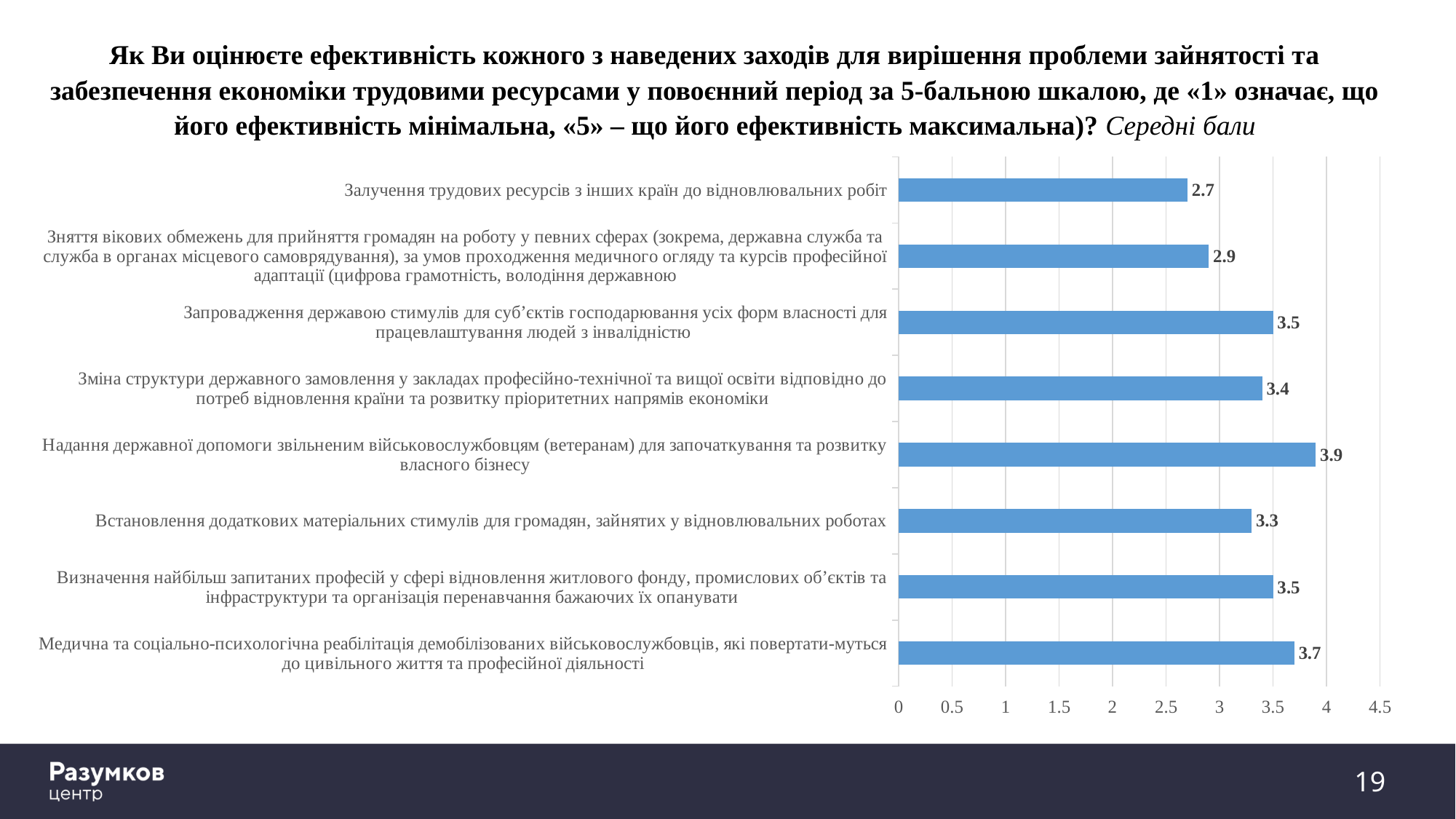
What type of chart is shown on the slide? Bar chart Which has a higher average score: 'Зміна структури державного замовлення у закладах професійно-технічної та вищої освіти' or 'Зняття вікових обмежень для прийняття громадян на роботу'? Зміна структури державного замовлення у закладах професійно-технічної та вищої освіти Is the average score for 'Зняття вікових обмежень для прийняття громадян на роботу' greater or less than 3? less What is the difference between the average score for state aid to veterans for starting a business (3.9) and the score for attracting labour from other countries (2.7)? 1.2 What is the average score for 'Медична та соціально-психологічна реабілітація демобілізованих військовослужбовців'? 3.7 How many measures are shown in the chart? 8 Which measure has the lowest average score? Залучення трудових ресурсів з інших країн до відновлювальних робіт What is the average score for 'Встановлення додаткових матеріальних стимулів для громадян, зайнятих у відновлювальних роботах'? 3.3 What is the average score for 'Залучення трудових ресурсів з інших країн до відновлювальних робіт'? 2.7 What is the maximum value shown on the horizontal axis of the chart? 4.5 What is the average score for 'Надання державної допомоги звільненим військовослужбовцям (ветеранам) для започаткування та розвитку власного бізнесу'? 3.9 Which measure has the highest average score? Надання державної допомоги звільненим військовослужбовцям (ветеранам) для започаткування та розвитку власного бізнесу